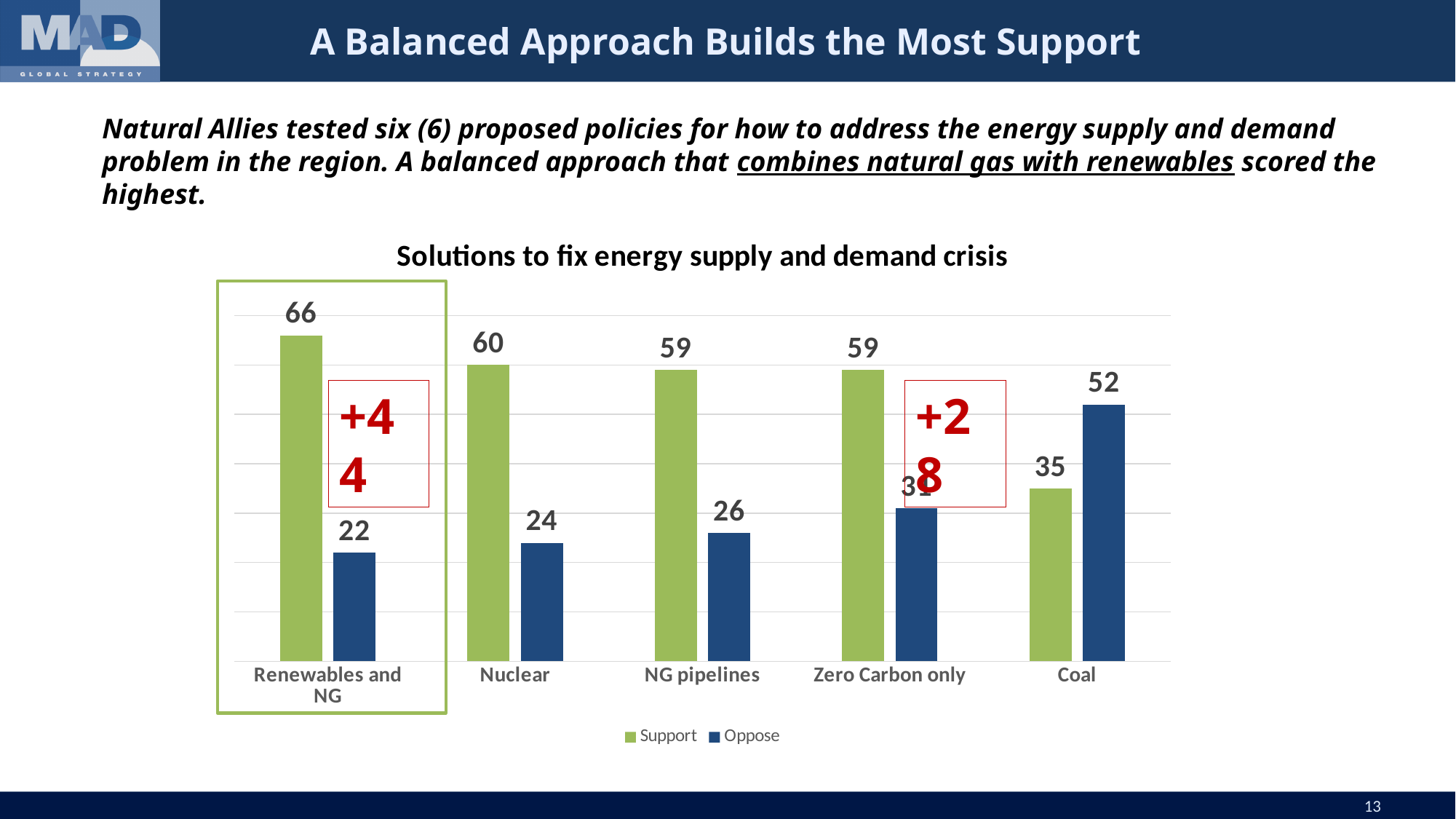
Which category has the lowest Support value? Coal What is the Oppose value for Nuclear? 24 How many series does the legend list? 2 Which category has the highest Support value? Renewables and NG Which is larger for Coal, the Support value or the Oppose value? Oppose What is the Support value for NG pipelines? 59 What is the Support value for Renewables and NG? 66 What is the difference between the Support and Oppose values for Renewables and NG? 44 What is the Oppose value for Coal? 52 How many categories are shown on the x axis of the chart? 5 Which category has the highest Oppose value? Coal What type of chart is shown on the slide? Bar chart